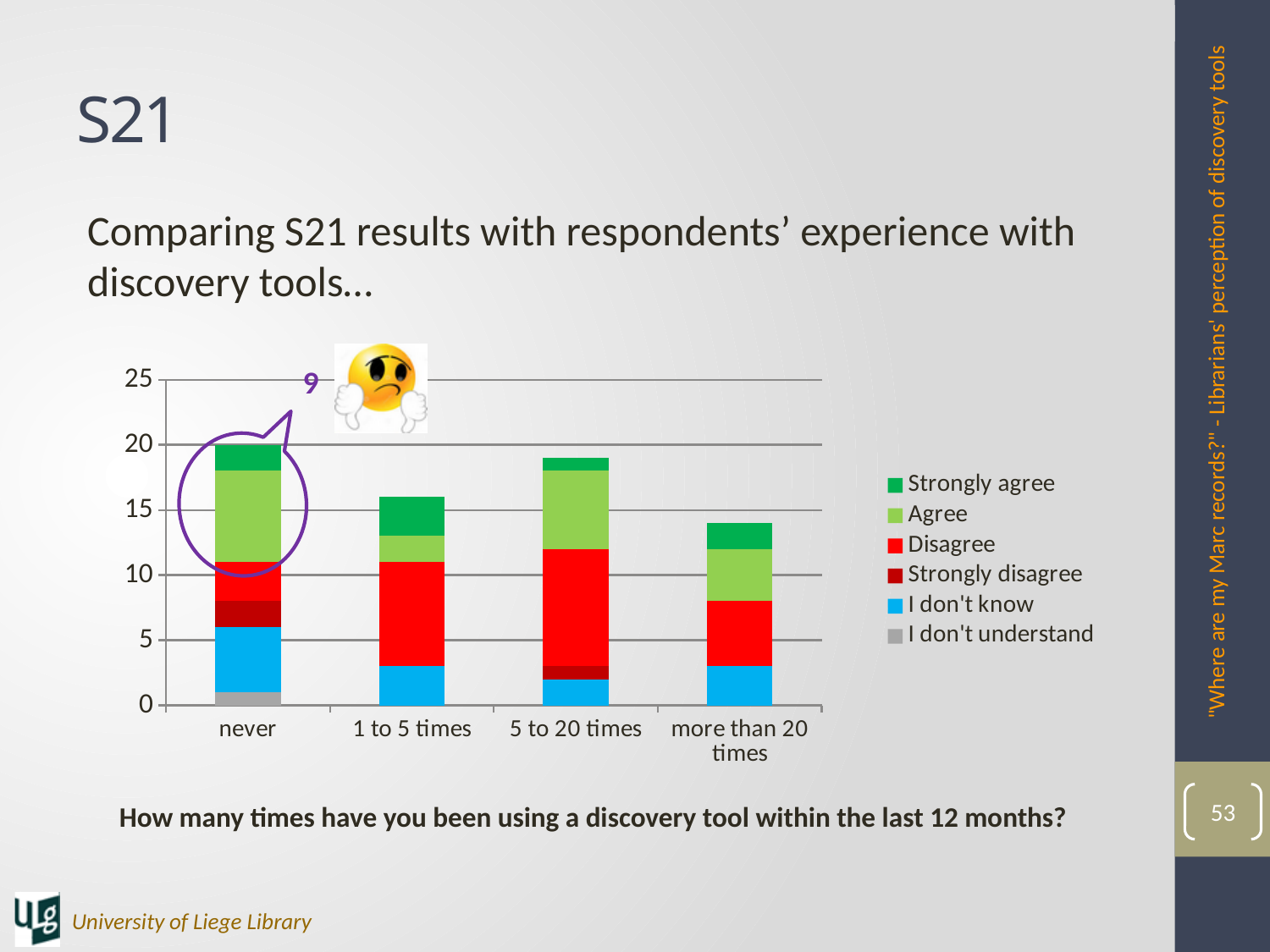
Which legend entry is shown in red in the chart? Disagree Is the total height of the stacked bar for 'more than 20 times' greater or less than 15? less Which category has the lowest total stacked bar? more than 20 times Is the total height of the stacked bar for '1 to 5 times' greater or less than 20? less Is the total height of the stacked bar for '5 to 20 times' greater or less than 15? greater Which stacked bar is taller overall, 'never' or 'more than 20 times'? never What kind of chart is shown on the slide? stacked bar chart Which stacked bar is taller overall, '5 to 20 times' or 'more than 20 times'? 5 to 20 times How many categories are shown on the x axis of the chart? 4 What is the first entry listed in the chart's legend? Strongly agree How many series does the chart's legend list? 6